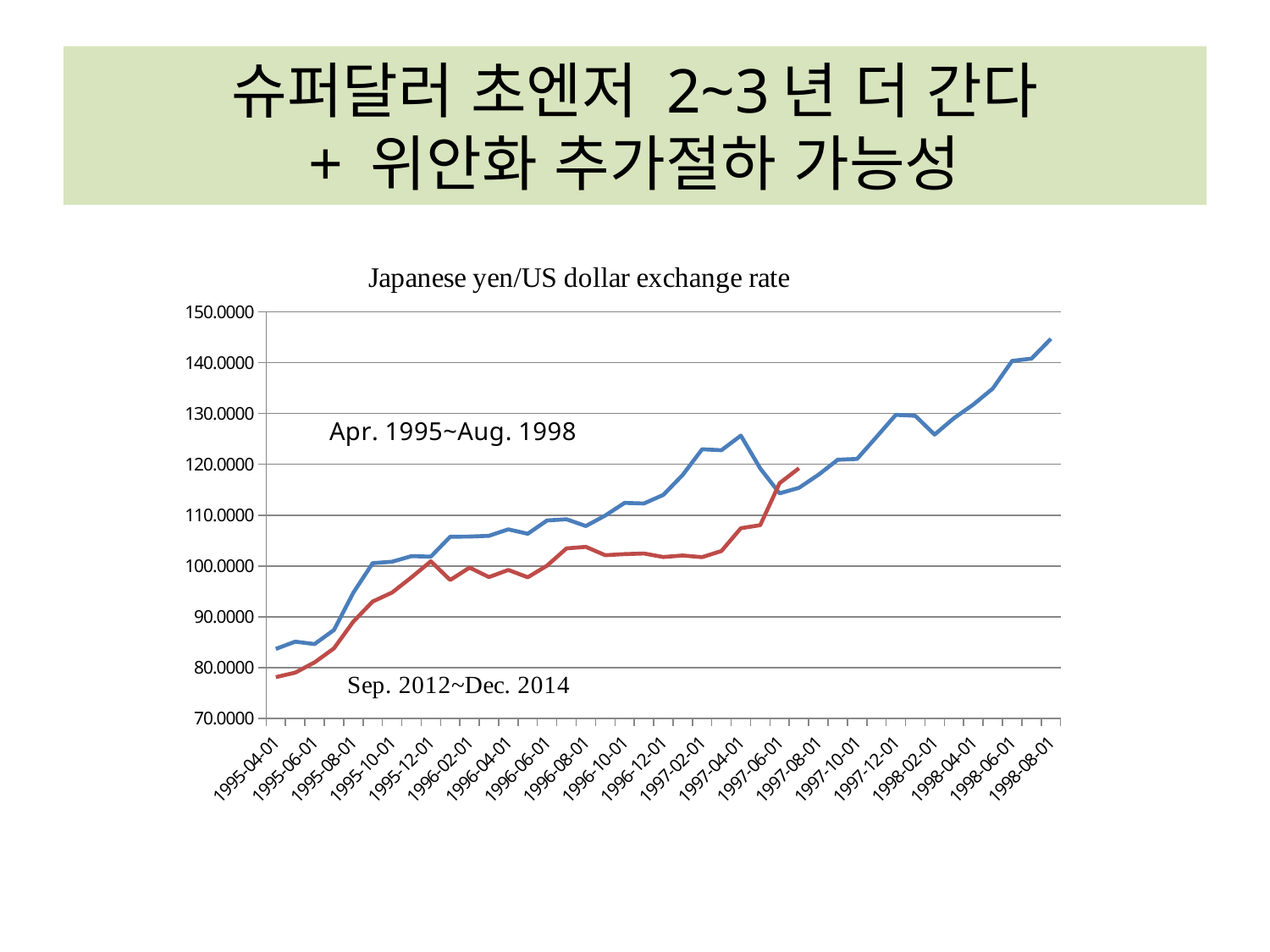
At which x-axis date does the blue line have its lowest value? 1995-04-01 Is the value of the blue line at 1995-04-01 greater or less than 90? less Which period does the blue line represent, according to the label on the chart? Apr. 1995~Aug. 1998 What type of chart is shown on the slide? line chart Is the value of the red line at 1995-04-01 greater or less than 80? less Is the value of the blue line at 1997-04-01 greater or less than 120? greater Does the red line (Sep. 2012~Dec. 2014) generally rise or fall from left to right? rise What is the title of the chart? Japanese yen/US dollar exchange rate At which x-axis date does the blue line reach its highest value? 1998-08-01 At 1996-08-01, which line has the higher value, the blue line or the red line? the blue line Does the blue line (Apr. 1995~Aug. 1998) generally rise or fall from left to right? rise